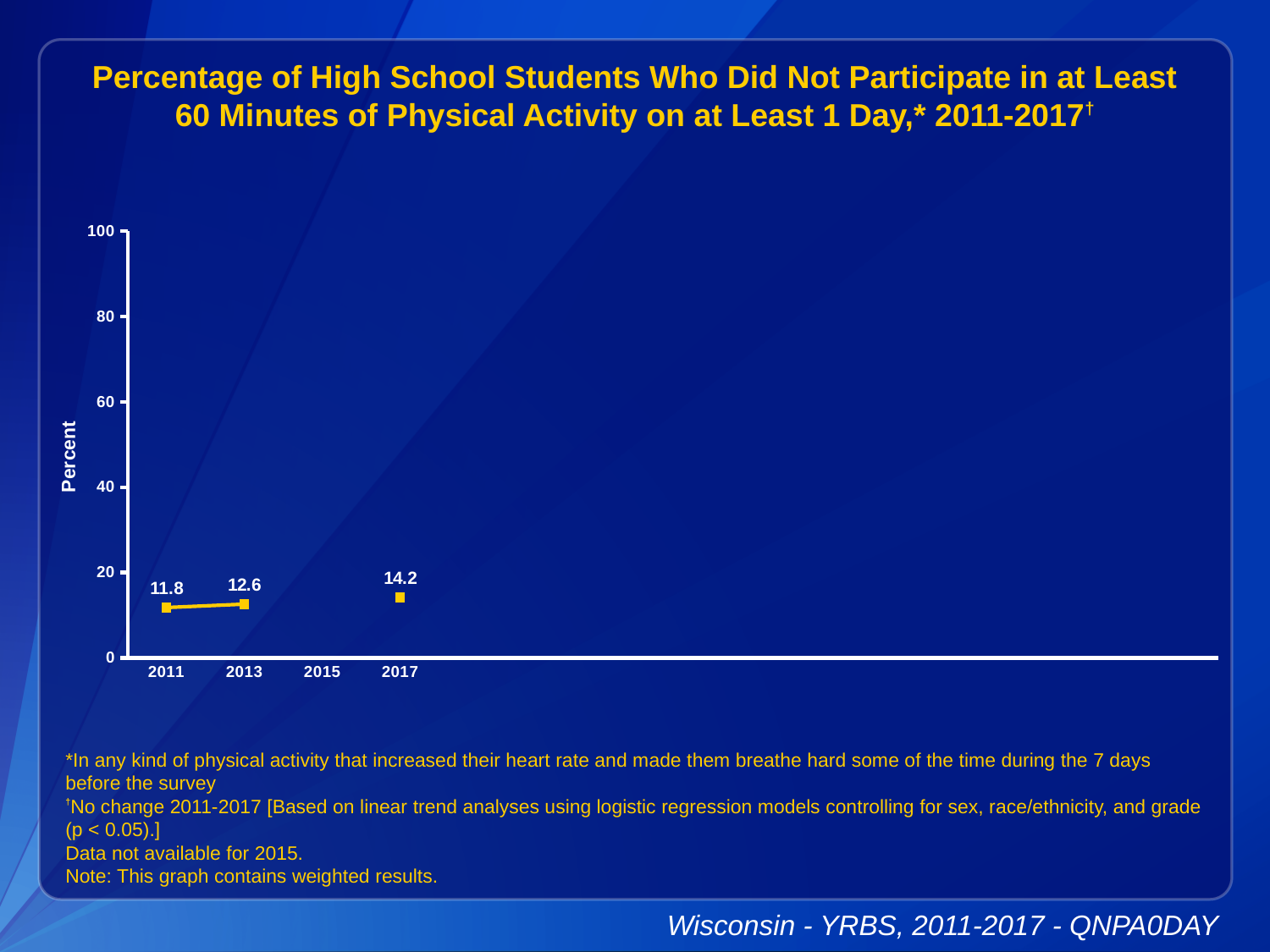
Which year has the lowest value? 2011 What is the value for 2017? 14.2 Is the value for 2017 greater or less than 20? less Do the plotted values rise or fall from 2011 to 2017? rise What is the difference between the values for 2017 and 2011? 2.4 What is the value for 2011? 11.8 What is the difference between the values for 2013 and 2011? 0.8 What kind of chart is shown on the slide? line chart Which is larger, the value for 2013 or the value for 2017? 2017 Which year has the highest value? 2017 How many data points are plotted on the chart? 3 What is the value for 2013? 12.6